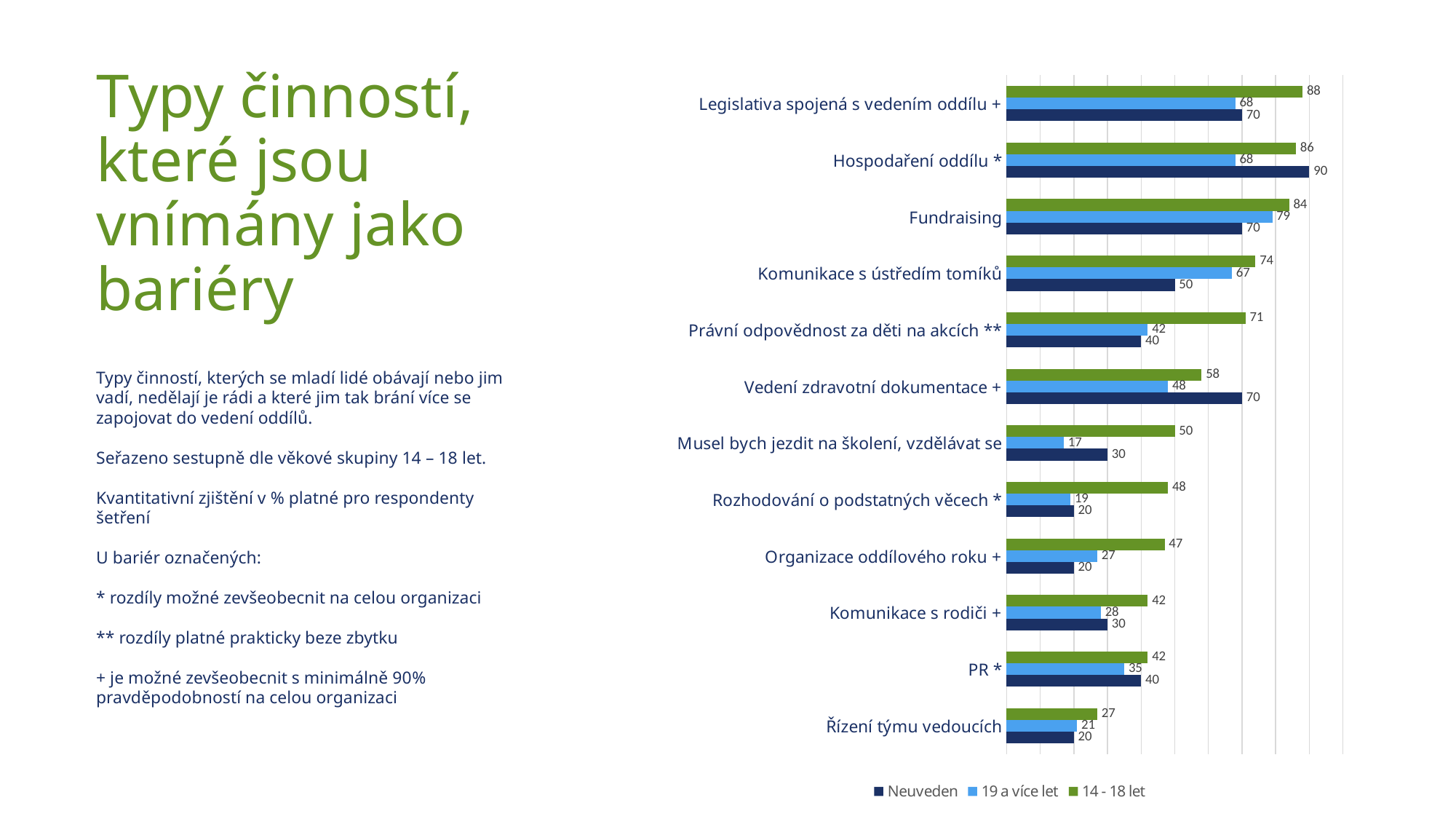
Which category has the lowest value for the "14 - 18 let" series? Řízení týmu vedoucích How many series does the legend list? 3 Which category has the highest value for the "14 - 18 let" series? Legislativa spojená s vedením oddílu + What is the value for "14 - 18 let" for "Legislativa spojená s vedením oddílu +"? 88 What is the value for "Neuveden" for "Hospodaření oddílu *"? 90 What kind of chart is shown on the slide? Bar chart What is the difference between the "14 - 18 let" value and the "19 a více let" value for "Právní odpovědnost za děti na akcích **"? 29 For "Fundraising", which series has the larger value: "19 a více let" or "Neuveden"? 19 a více let What is the value for "19 a více let" for "Musel bych jezdit na školení, vzdělávat se"? 17 For "Vedení zdravotní dokumentace +", which series has the larger value: "Neuveden" or "14 - 18 let"? Neuveden Which series is shown in green in the legend? 14 - 18 let How many categories are shown on the chart? 12